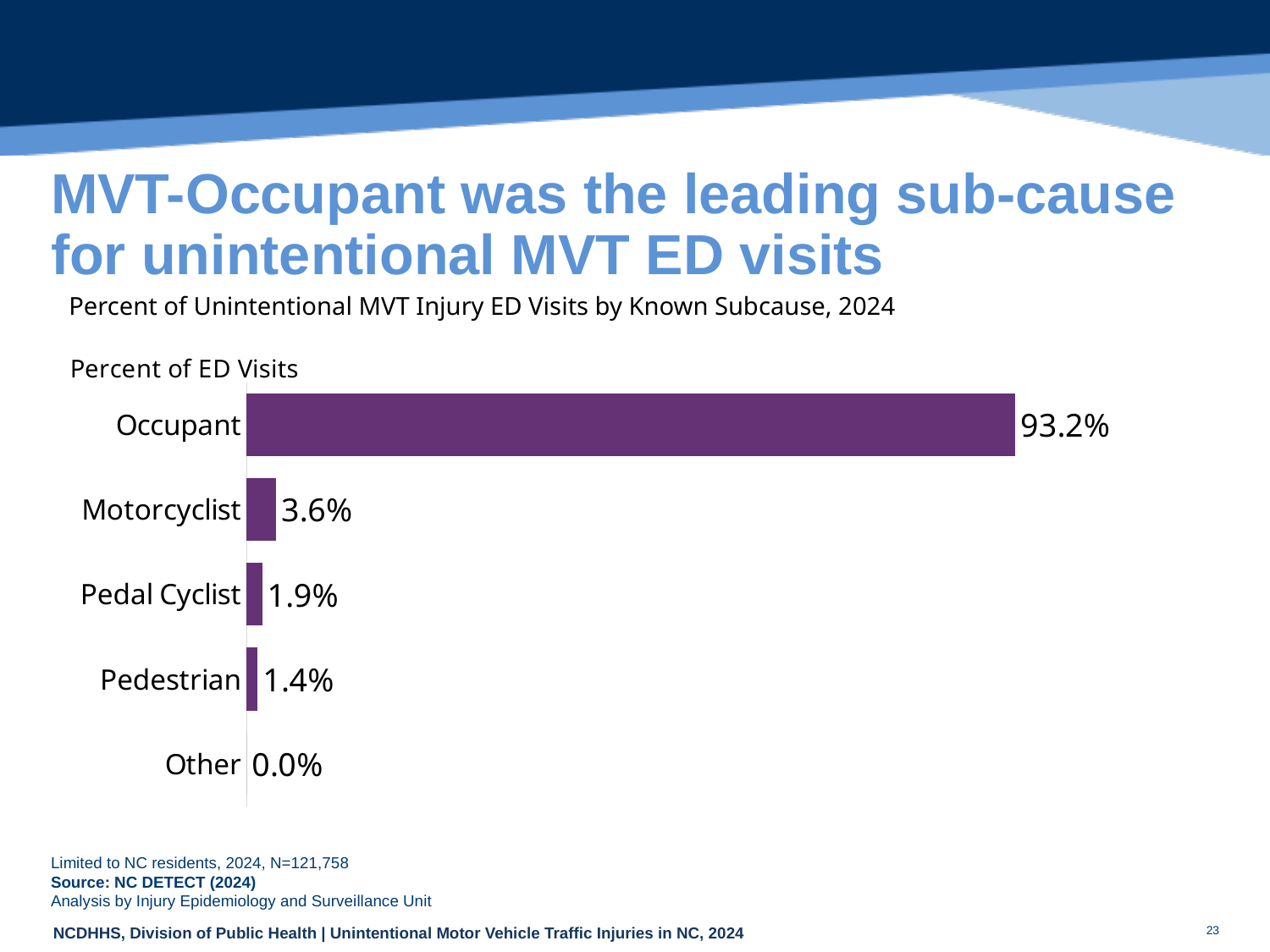
What is the difference in percentage points between Occupant and Motorcyclist? 89.6 Which subcause has the lowest percent of ED visits? Other What type of chart is shown on the slide? Bar chart Which has a larger percent of ED visits, Pedal Cyclist or Pedestrian? Pedal Cyclist What percent of ED visits is shown for Occupant? 93.2% What percent of ED visits is shown for Pedal Cyclist? 1.9% How many subcause categories are shown in the chart? 5 Which subcause has the highest percent of ED visits? Occupant What percent of ED visits is shown for Other? 0.0% What is the difference in percentage points between Motorcyclist and Pedal Cyclist? 1.7 What percent of ED visits is shown for Motorcyclist? 3.6% What percent of ED visits is shown for Pedestrian? 1.4%